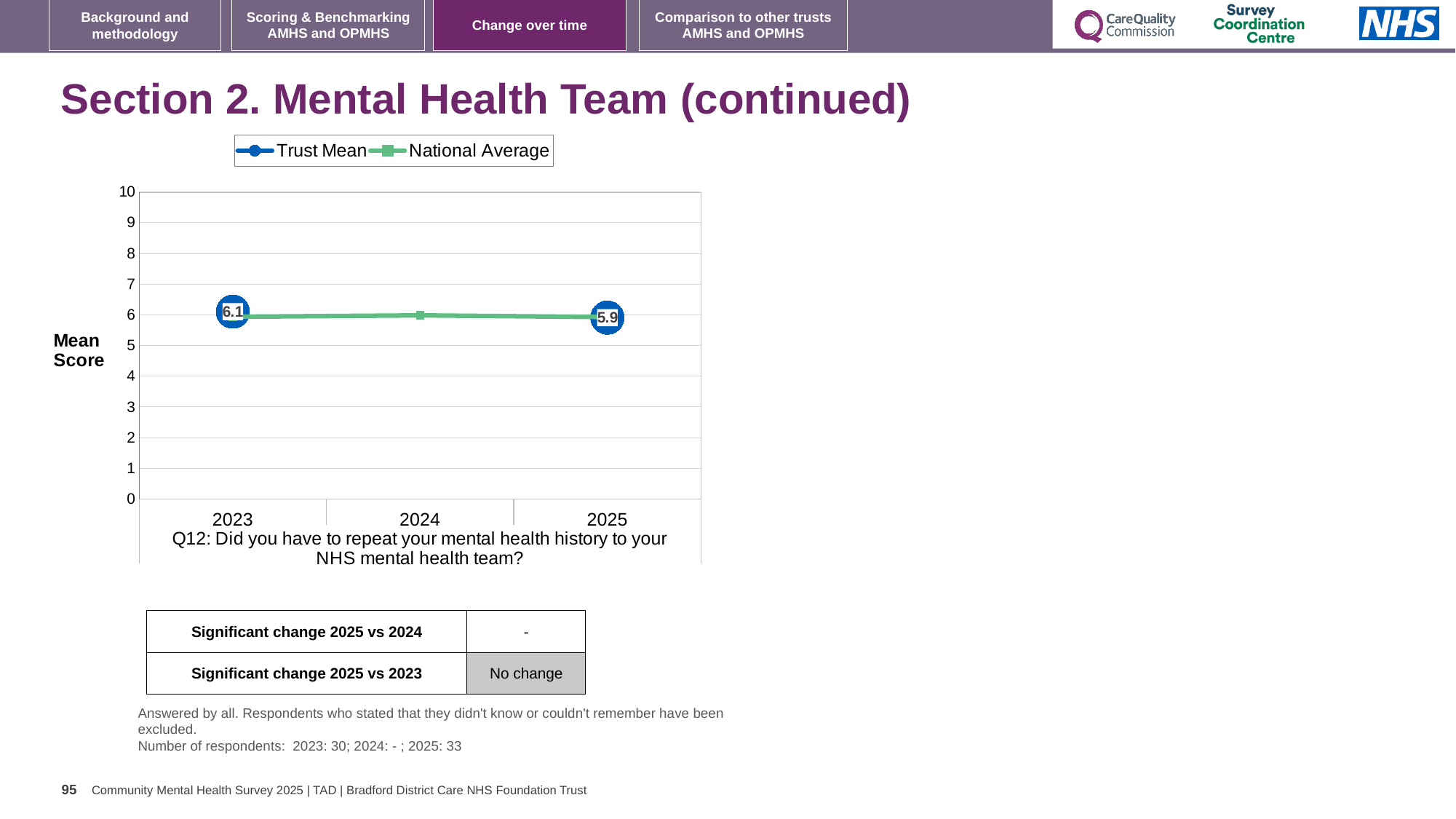
Which year has the higher Trust Mean score, 2023 or 2025? 2023 What is the label on the y axis of the chart? Mean Score What kind of chart is shown on the slide? line chart What is the Trust Mean score for 2023? 6.1 What is the Trust Mean score for 2025? 5.9 Is the National Average value for 2024 greater or less than 7? less Does the Trust Mean rise or fall from 2023 to 2025? fall How many years are shown on the x axis? 3 Is the National Average value for 2024 greater or less than 5? greater How many series does the legend list? 2 What is the difference between the Trust Mean score in 2023 and in 2025? 0.2 What are the two series named in the legend? Trust Mean and National Average